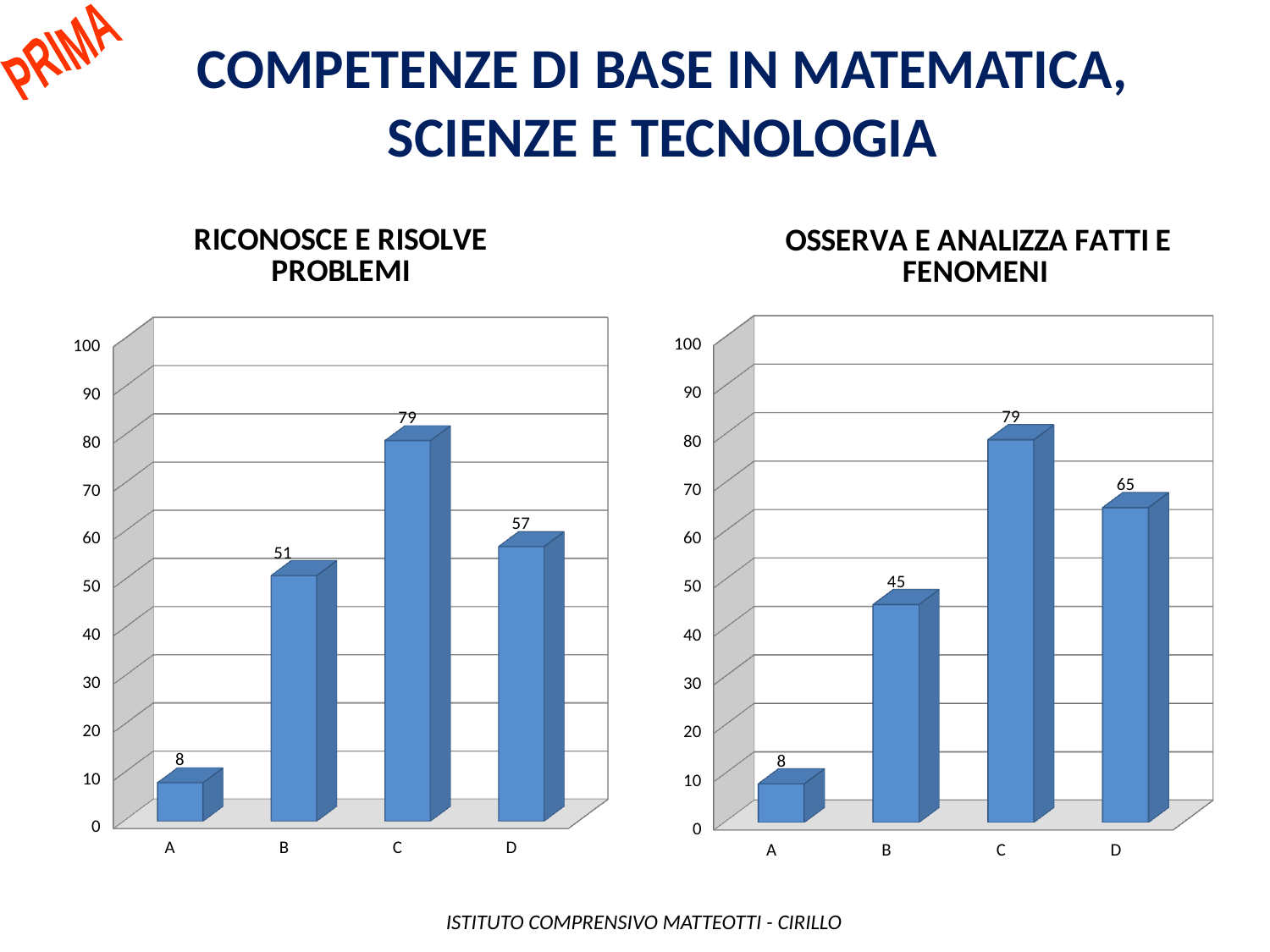
How many categories are shown in the chart titled "RICONOSCE E RISOLVE PROBLEMI"? 4 What is the title of the chart on the right side of the slide? OSSERVA E ANALIZZA FATTI E FENOMENI In the chart titled "OSSERVA E ANALIZZA FATTI E FENOMENI", is the value for D greater or less than 60? greater In the chart titled "RICONOSCE E RISOLVE PROBLEMI", which is larger, the value for B or the value for D? D In the chart titled "OSSERVA E ANALIZZA FATTI E FENOMENI", what is the difference between the values for D and B? 20 In the chart titled "OSSERVA E ANALIZZA FATTI E FENOMENI", what is the value for category B? 45 In the chart titled "RICONOSCE E RISOLVE PROBLEMI", what is the value for category C? 79 In the chart titled "RICONOSCE E RISOLVE PROBLEMI", which category has the lowest value? A In the chart titled "RICONOSCE E RISOLVE PROBLEMI", what is the value for category A? 8 In the chart titled "RICONOSCE E RISOLVE PROBLEMI", what is the difference between the values for C and D? 22 In the chart titled "OSSERVA E ANALIZZA FATTI E FENOMENI", which category has the highest value? C What kind of chart is the chart titled "OSSERVA E ANALIZZA FATTI E FENOMENI"? bar chart